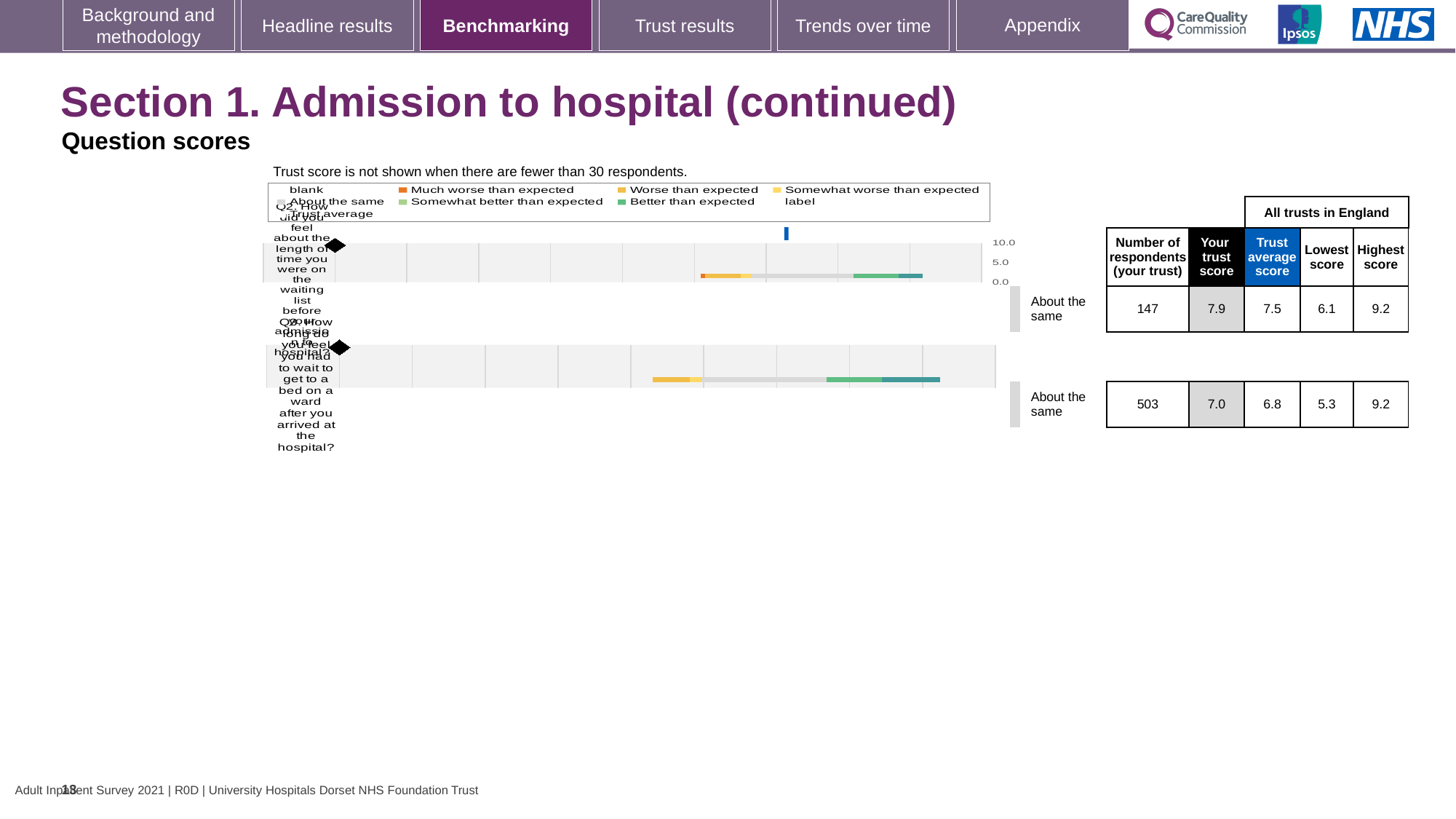
For the Q2 chart, is the trust score higher or lower than the trust average score? higher For the Q3 chart, what is the trust average score for all trusts in England? 6.8 For the Q3 chart, what is the difference between the highest score and the lowest score across all trusts in England? 3.9 For the Q3 chart (wait to get to a bed on a ward), what is the trust score shown in the table? 7.0 For the Q2 chart, what is the difference between the trust score and the trust average score? 0.4 For the Q2 chart, what is the lowest score among all trusts in England? 6.1 For the Q3 chart, what benchmark category is the trust placed in? About the same What kind of chart is used to show the benchmarking results for Q2 and Q3 on this slide? bar chart How many questions (Q2 and Q3) have benchmarking charts on this slide? 2 For the Q2 chart (length of time on the waiting list), what is the trust score shown in the table? 7.9 For the Q2 chart, how many respondents does the table show for the trust? 147 Which question, Q2 or Q3, has the larger number of respondents for the trust? Q3